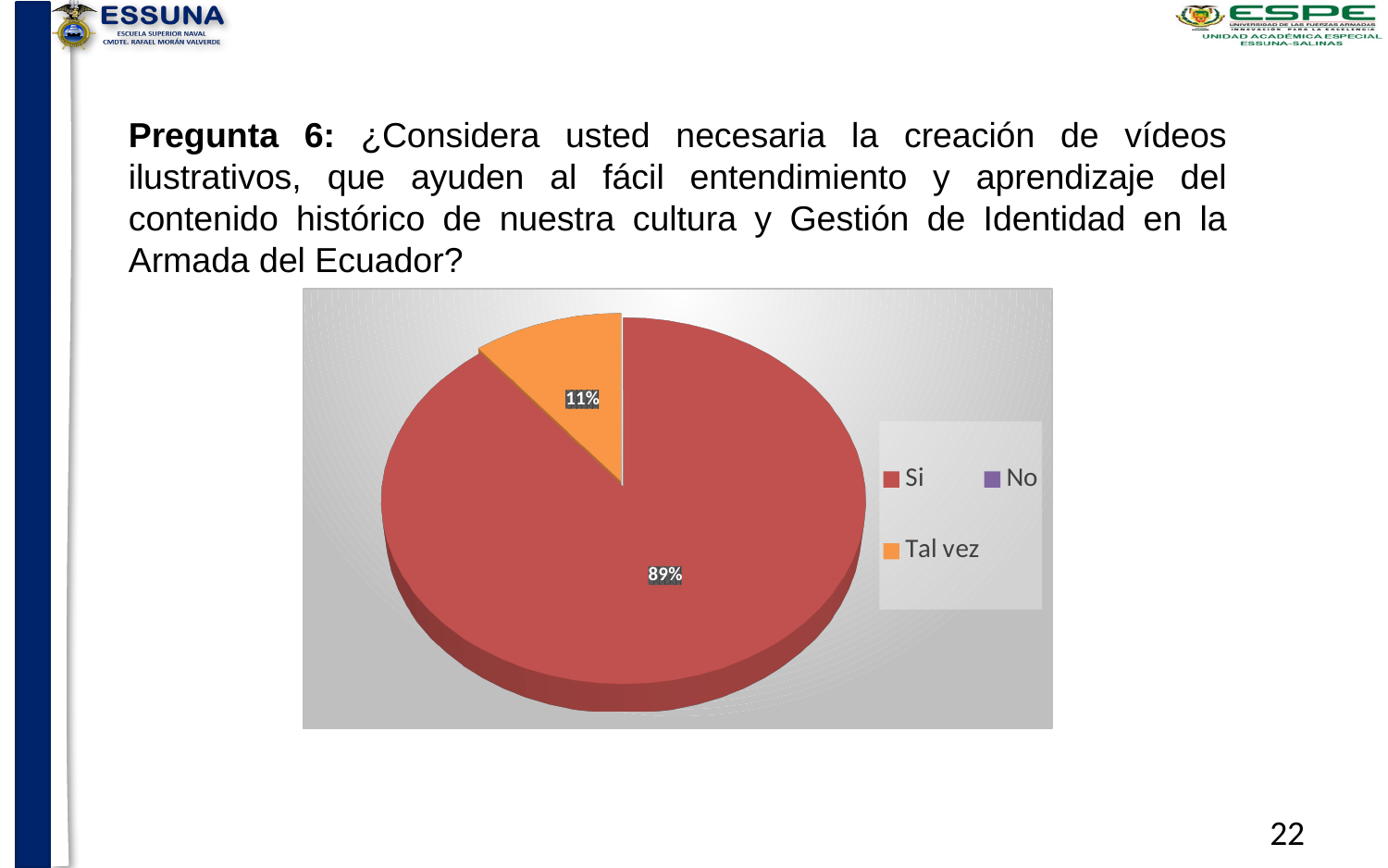
How many slices with a printed percentage label are visible in the pie? 2 What is the difference in percentage points between the "Si" slice and the "Tal vez" slice? 78 Which category has the largest share of the pie? Si What colour is the "Si" slice of the pie? red How many entries does the legend list? 3 Which of the two labelled slices is larger, "Si" or "Tal vez"? Si What are the three entries listed in the legend? Si, No, Tal vez Is the share for "Si" greater or less than 50%? greater What percentage of the pie corresponds to "Si"? 89% What percentage of the pie corresponds to "Tal vez"? 11% What kind of chart is shown on the slide? pie chart